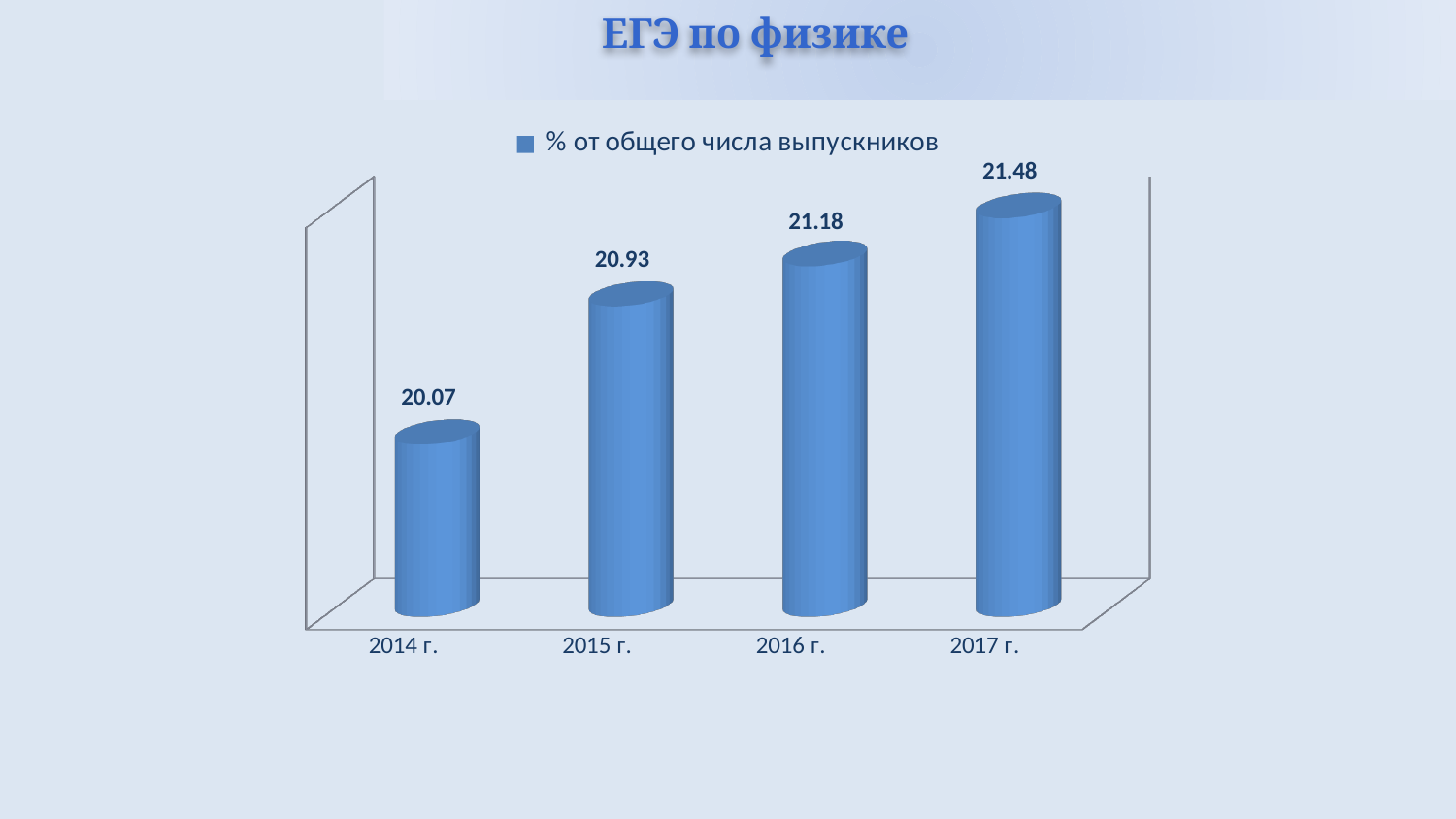
Which is larger, the value for 2015 г. or the value for 2016 г.? 2016 г. How many years are shown on the chart? 4 What is the difference between the values for 2015 г. and 2014 г.? 0.86 What is the value for 2016 г.? 21.18 What is the value for 2017 г.? 21.48 What is the difference between the values for 2017 г. and 2014 г.? 1.41 Do the values rise or fall from 2014 г. to 2017 г.? Rise Which year has the lowest value? 2014 г. What kind of chart is shown on the slide? Bar chart What is the value for 2015 г.? 20.93 Which year has the highest value? 2017 г. What is the value for 2014 г.? 20.07